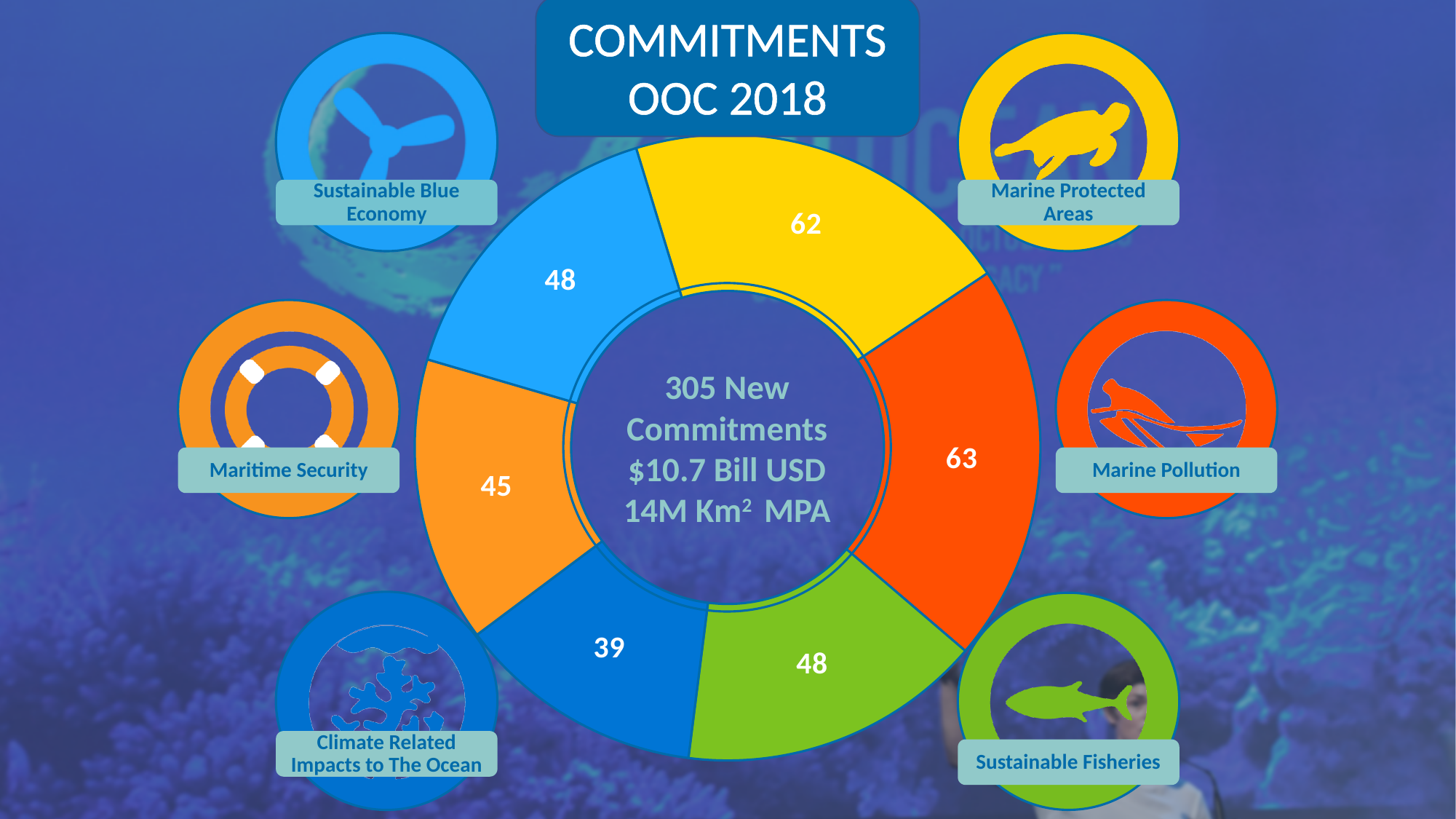
What is the value for Climate Related Impacts to The Ocean? 39 What is the value for Marine Protected Areas? 62 How many segments does the donut chart have? 6 Which category has the highest value? Marine Pollution What is the value for Maritime Security? 45 What kind of chart is shown on the slide? Donut chart What is the title of the slide? COMMITMENTS OOC 2018 What is the value for Marine Pollution? 63 What is the total number of new commitments shown in the centre of the chart? 305 Which is larger, the value for Sustainable Fisheries or the value for Maritime Security? Sustainable Fisheries What is the difference between the values for Marine Pollution and Climate Related Impacts to The Ocean? 24 Which category has the lowest value? Climate Related Impacts to The Ocean